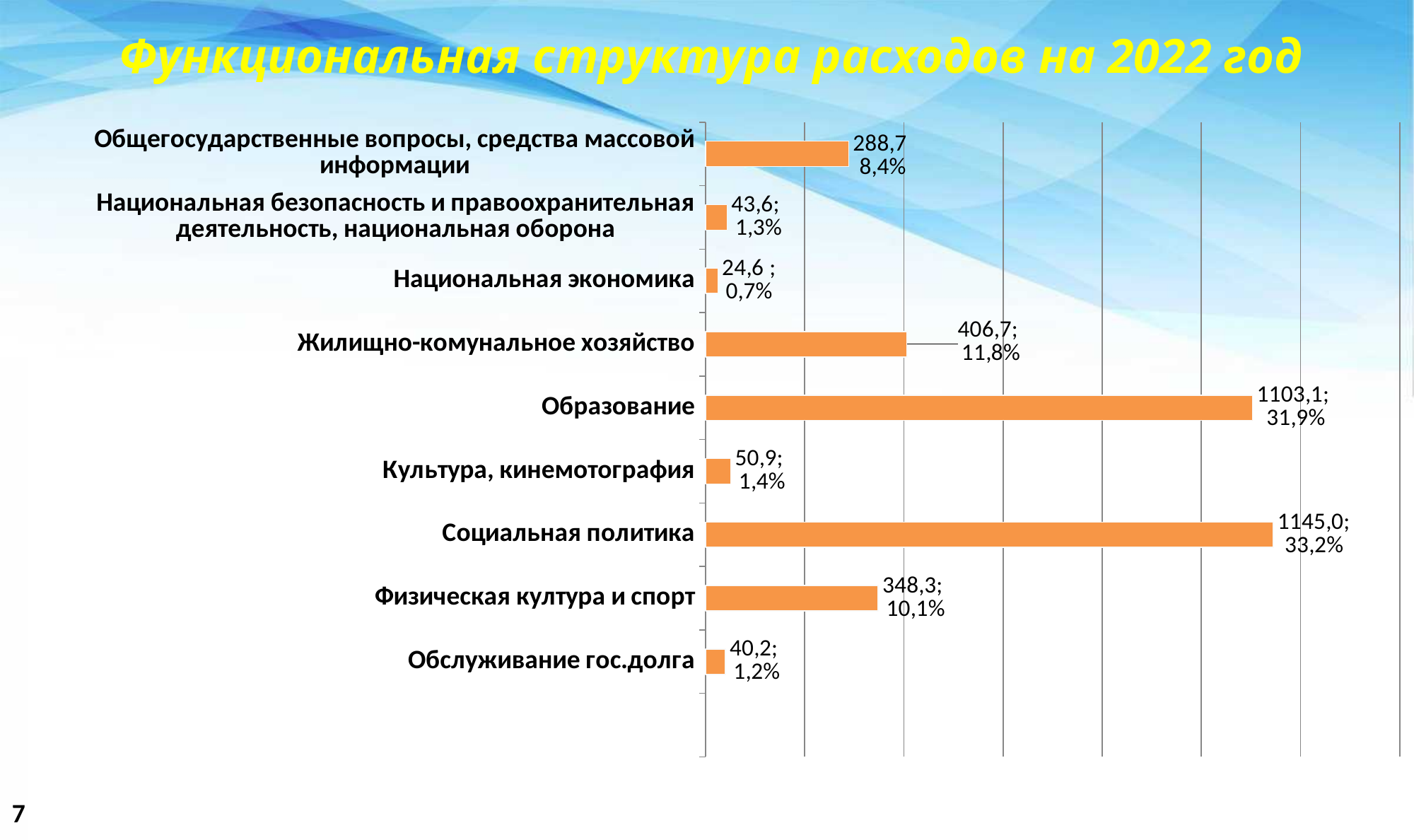
How many categories are shown in the chart? 9 What value is shown for Жилищно-комунальное хозяйство? 406,7 Which category has the lowest value? Национальная экономика What percentage share is shown for Социальная политика? 33,2% What is the difference between the values for Социальная политика and Образование? 41,9 What type of chart is shown on the slide? Bar chart What value is shown for Образование? 1103,1 Which is larger, the value for Культура, кинемотография or the value for Обслуживание гос.долга? Культура, кинемотография What is the difference between the values for Жилищно-комунальное хозяйство and Физическая култура и спорт? 58,4 Which category has the highest value? Социальная политика What is the title of the slide? Функциональная структура расходов на 2022 год What percentage is shown for Физическая култура и спорт? 10,1%